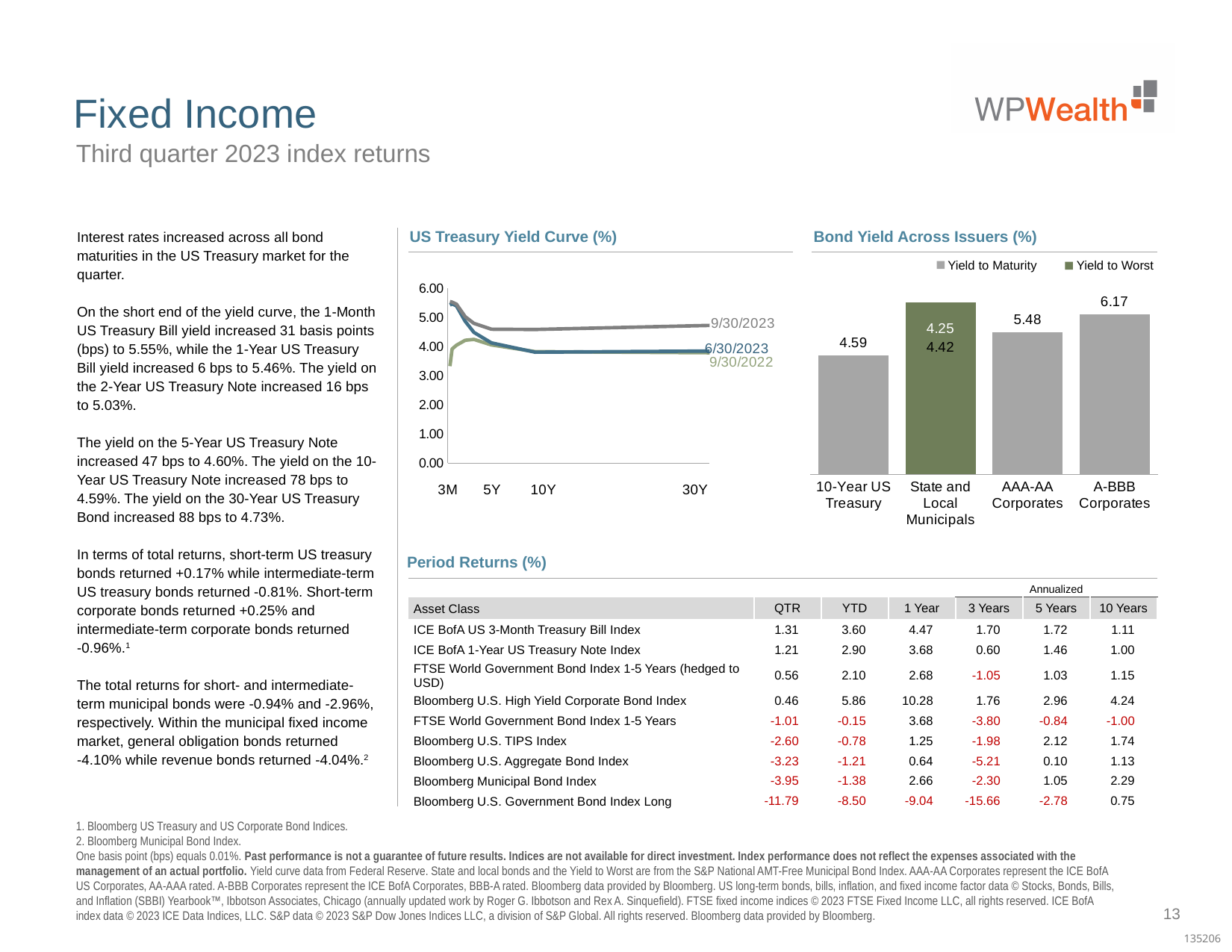
In the Bond Yield Across Issuers (%) chart, what is the value for A-BBB Corporates? 6.17 How many series does the legend of the Bond Yield Across Issuers (%) chart list? 2 In the Bond Yield Across Issuers (%) chart, which category has the highest value? A-BBB Corporates In the Bond Yield Across Issuers (%) chart, what is the value for 10-Year US Treasury? 4.59 In the Bond Yield Across Issuers (%) chart, which is larger, AAA-AA Corporates or 10-Year US Treasury? AAA-AA Corporates In the Bond Yield Across Issuers (%) chart, what is the value for AAA-AA Corporates? 5.48 How many categories are shown on the x axis of the Bond Yield Across Issuers (%) chart? 4 What kind of chart is the Bond Yield Across Issuers (%) chart? bar chart What kind of chart is the US Treasury Yield Curve (%) chart? line chart In the Bond Yield Across Issuers (%) chart, what is the difference between A-BBB Corporates and AAA-AA Corporates? 0.69 In the US Treasury Yield Curve (%) chart, which dated line is highest at 30Y? 9/30/2023 In the US Treasury Yield Curve (%) chart, is the 9/30/2023 value at 30Y greater or less than 4.00? greater